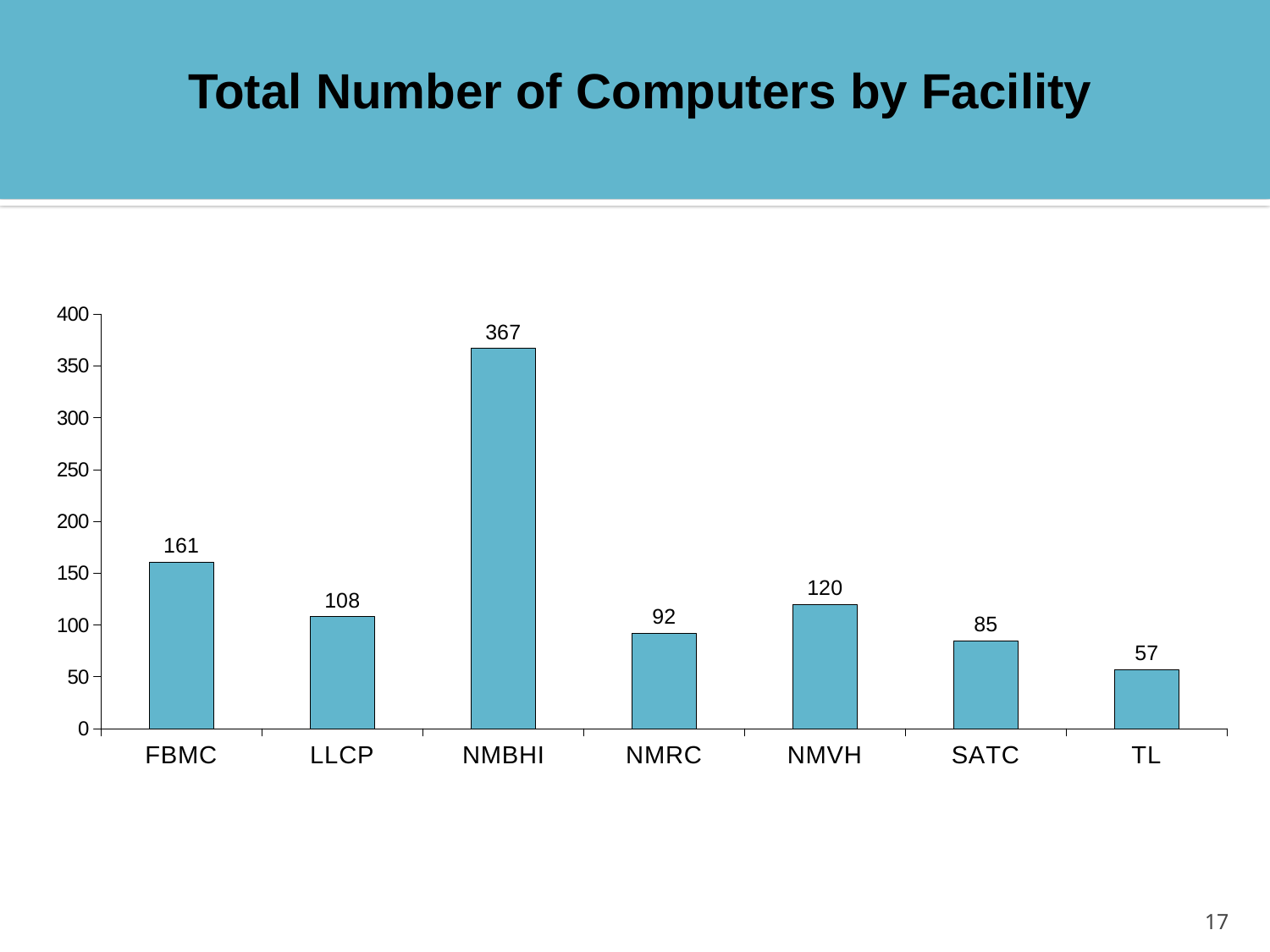
What is the title of the chart? Total Number of Computers by Facility Which facility has the lowest number of computers? TL How many computers does NMBHI have? 367 What is the value for FBMC? 161 What kind of chart is shown on the slide? bar chart What is the value for SATC? 85 Is the value for NMRC greater or less than 100? less What is the difference between the values for NMVH and NMRC? 28 How many facilities are shown on the chart? 7 Which facility has the highest number of computers? NMBHI What is the difference between the values for NMBHI and FBMC? 206 Which has more computers, LLCP or NMVH? NMVH